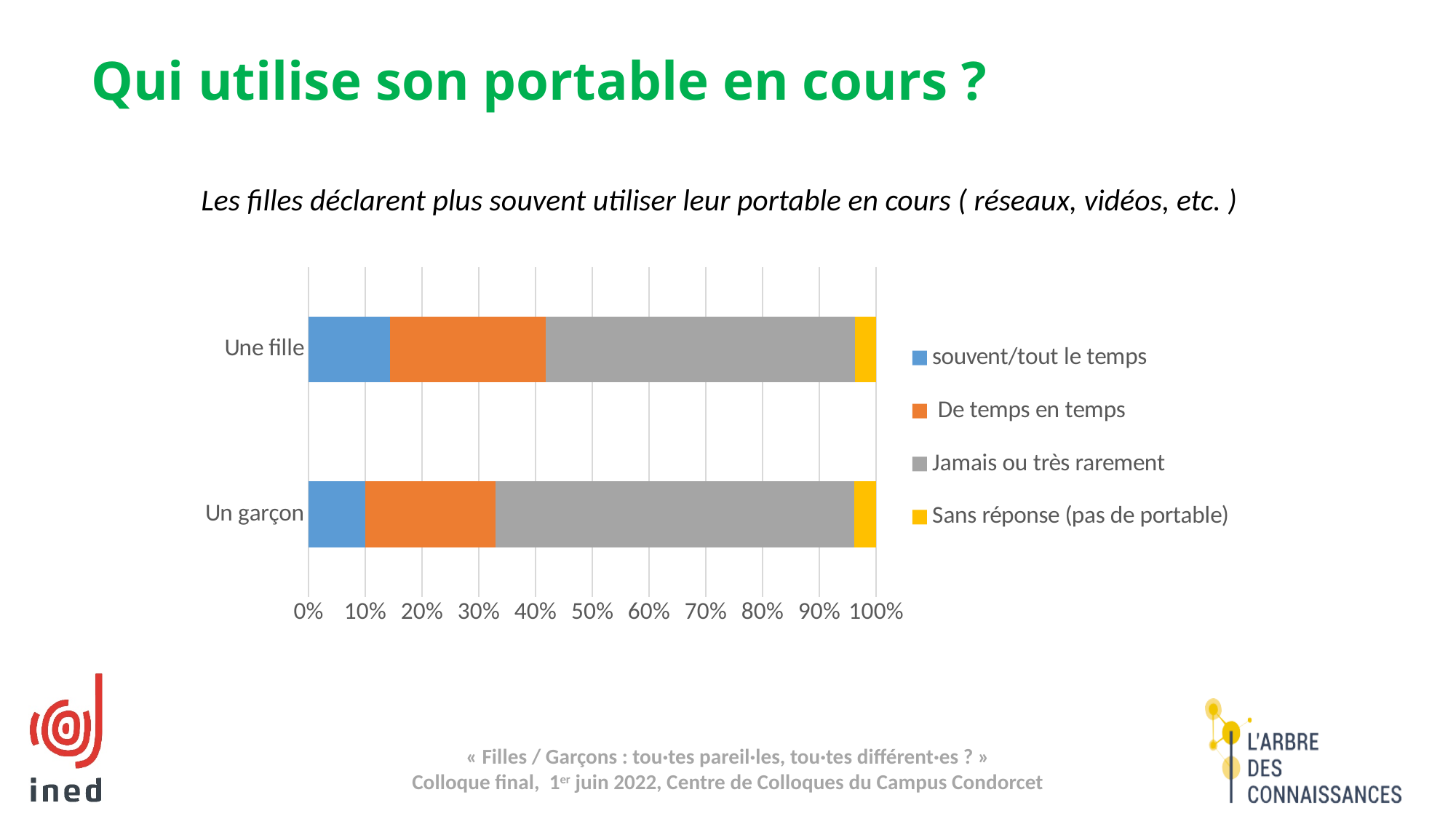
Is the 'De temps en temps' value for 'Une fille' greater or less than 20%? greater Is the 'Sans réponse (pas de portable)' value for 'Un garçon' greater or less than 10%? less Is the 'souvent/tout le temps' value for 'Une fille' greater or less than 10%? greater Which legend entry is shown in yellow? Sans réponse (pas de portable) What is the title of the slide containing the chart? Qui utilise son portable en cours ? Which category has the larger 'Jamais ou très rarement' segment, 'Une fille' or 'Un garçon'? Un garçon What kind of chart is shown on the slide? Stacked bar chart Which category has the larger 'De temps en temps' segment, 'Une fille' or 'Un garçon'? Une fille How many series does the chart legend list? 4 Which category has the larger 'souvent/tout le temps' segment, 'Une fille' or 'Un garçon'? Une fille How many categories are plotted on the y axis of the chart? 2